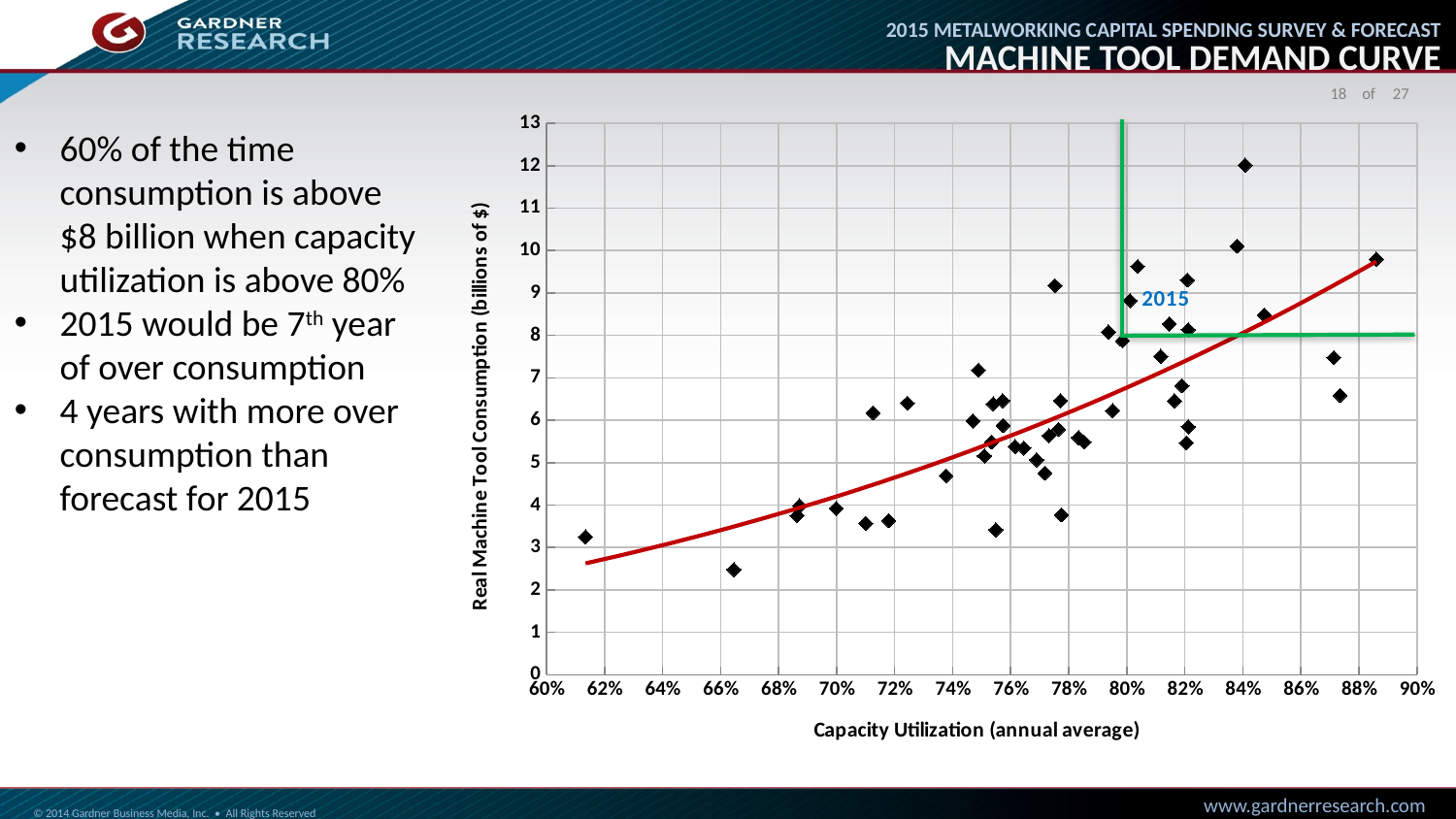
Which has the higher consumption value: the leftmost plotted point or the rightmost plotted point? the rightmost point What is the label of the vertical axis of the chart? Real Machine Tool Consumption (billions of $) Is the rightmost plotted point (near 88% capacity utilization) greater or less than 9? greater Is the lowest plotted point on the chart greater or less than 3? less Is the value of the point labeled 2015 greater or less than 8? greater What kind of chart is shown on the slide? scatter chart As capacity utilization increases along the x axis, does real machine tool consumption generally rise or fall? rise What is the title of the chart on the slide? Machine Tool Demand Curve Which has the higher consumption value: the point labeled 2015 or the highest point near 84% capacity utilization? the point near 84%